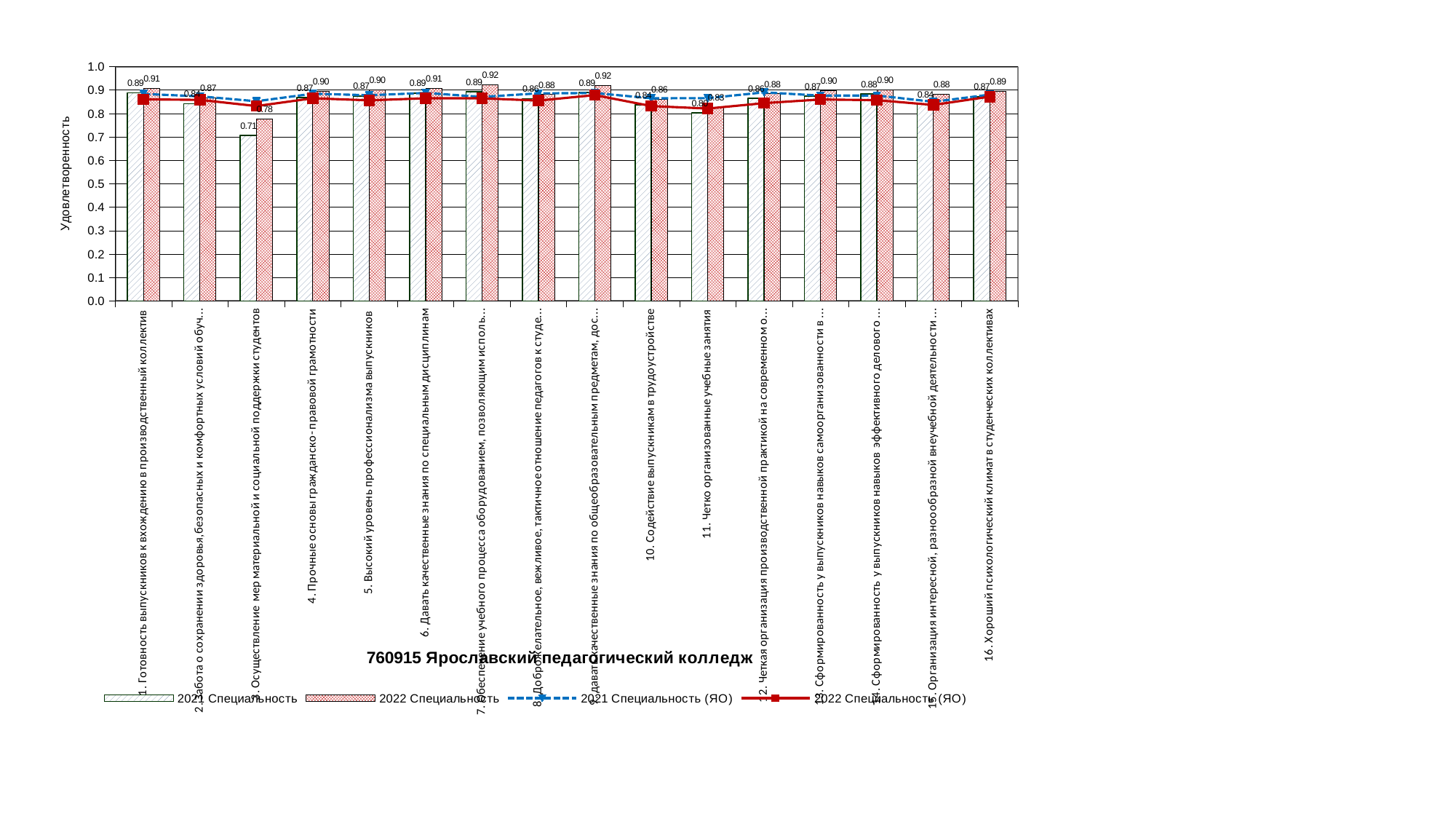
How many categories are plotted along the x axis? 16 What is the 2022 Специальность value for "16. Хороший психологический климат в студенческих коллективах"? 0.89 What kind of chart is shown on the slide? bar and line chart What is the title of the chart? 760915 Ярославский педагогический колледж What is the 2022 Специальность value for "10. Содействие выпускникам в трудоустройстве"? 0.86 What is the 2021 Специальность value for "5. Высокий уровень профессионализма выпускников"? 0.87 What is the 2021 Специальность value for "3. Осуществление мер материальной и социальной поддержки студентов"? 0.71 What is the difference between the 2022 Специальность and 2021 Специальность values for "3. Осуществление мер материальной и социальной поддержки студентов"? 0.07 For "11. Четко организованные учебные занятия", which is larger: the 2021 Специальность value or the 2022 Специальность value? 2022 Специальность What is the highest value shown among the 2022 Специальность bars? 0.92 How many series does the legend list? 4 Which category has the lowest 2021 Специальность value? 3. Осуществление мер материальной и социальной поддержки студентов